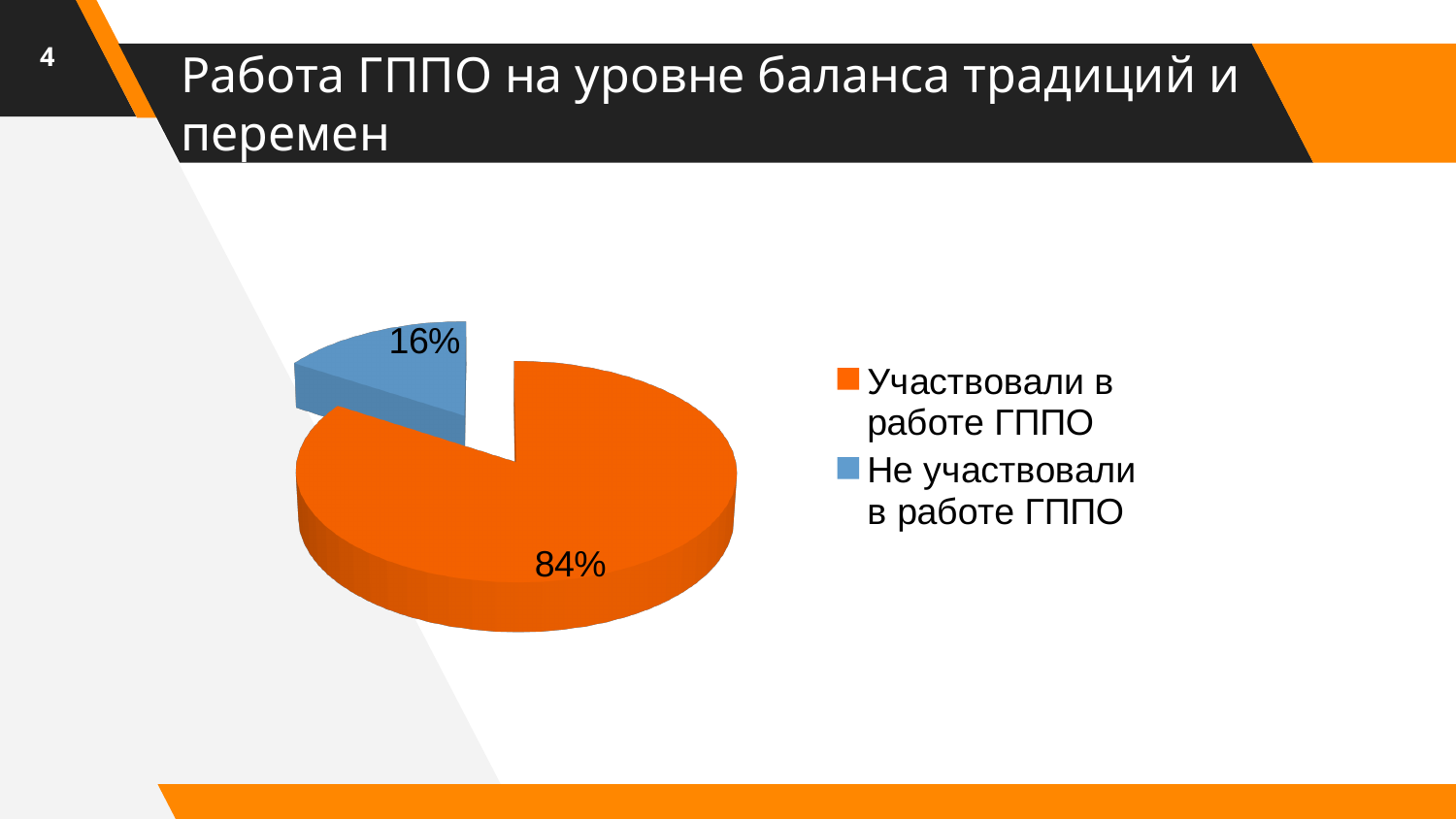
What share of the pie is labelled "Не участвовали в работе ГППО"? 16% What kind of chart is shown on the slide? Pie chart How many categories does the pie chart have? 2 What colour is the slice for "Участвовали в работе ГППО"? Orange How many entries does the legend list? 2 What share of the pie is labelled "Участвовали в работе ГППО"? 84% Which category has the largest slice of the pie? Участвовали в работе ГППО What colour is the slice for "Не участвовали в работе ГППО"? Blue What is the difference in percentage points between the "Участвовали в работе ГППО" slice and the "Не участвовали в работе ГППО" slice? 68 percentage points Which category has the smallest slice of the pie? Не участвовали в работе ГППО Which is larger: the share for "Участвовали в работе ГППО" or the share for "Не участвовали в работе ГППО"? Участвовали в работе ГППО